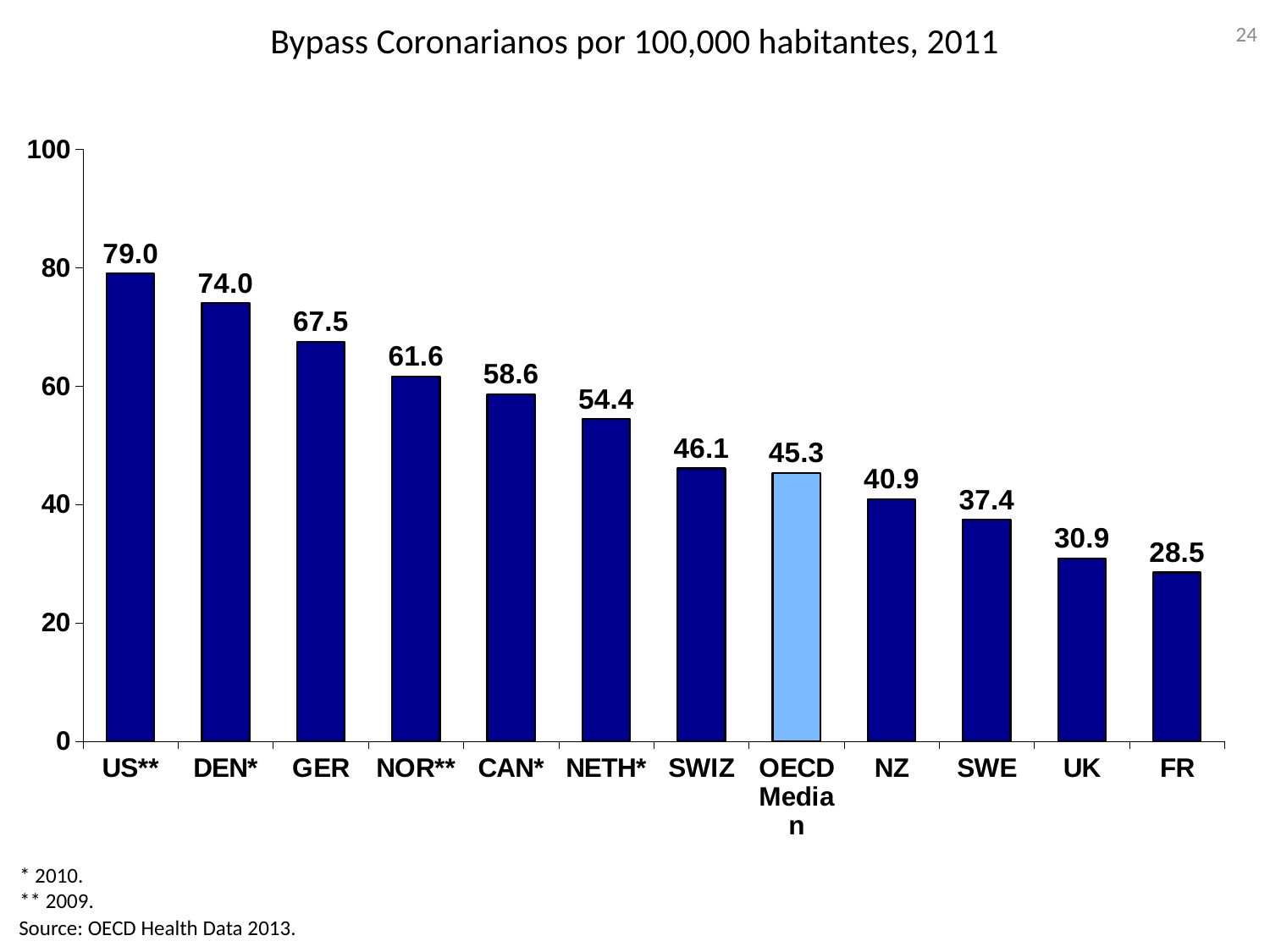
What is the value for GER? 67.5 Do the values rise or fall from left to right along the x axis? fall What is the value for the OECD Median? 45.3 How many categories are shown on the x axis? 12 What kind of chart is this? bar chart Which is larger, the value for NZ or the value for SWE? NZ Which category has the lowest value? FR What is the value for UK? 30.9 Which category has the highest value? US** Is the value for CAN* greater or less than 60? less What is the difference between the values for US** and DEN*? 5.0 What is the difference between the values for SWIZ and the OECD Median? 0.8